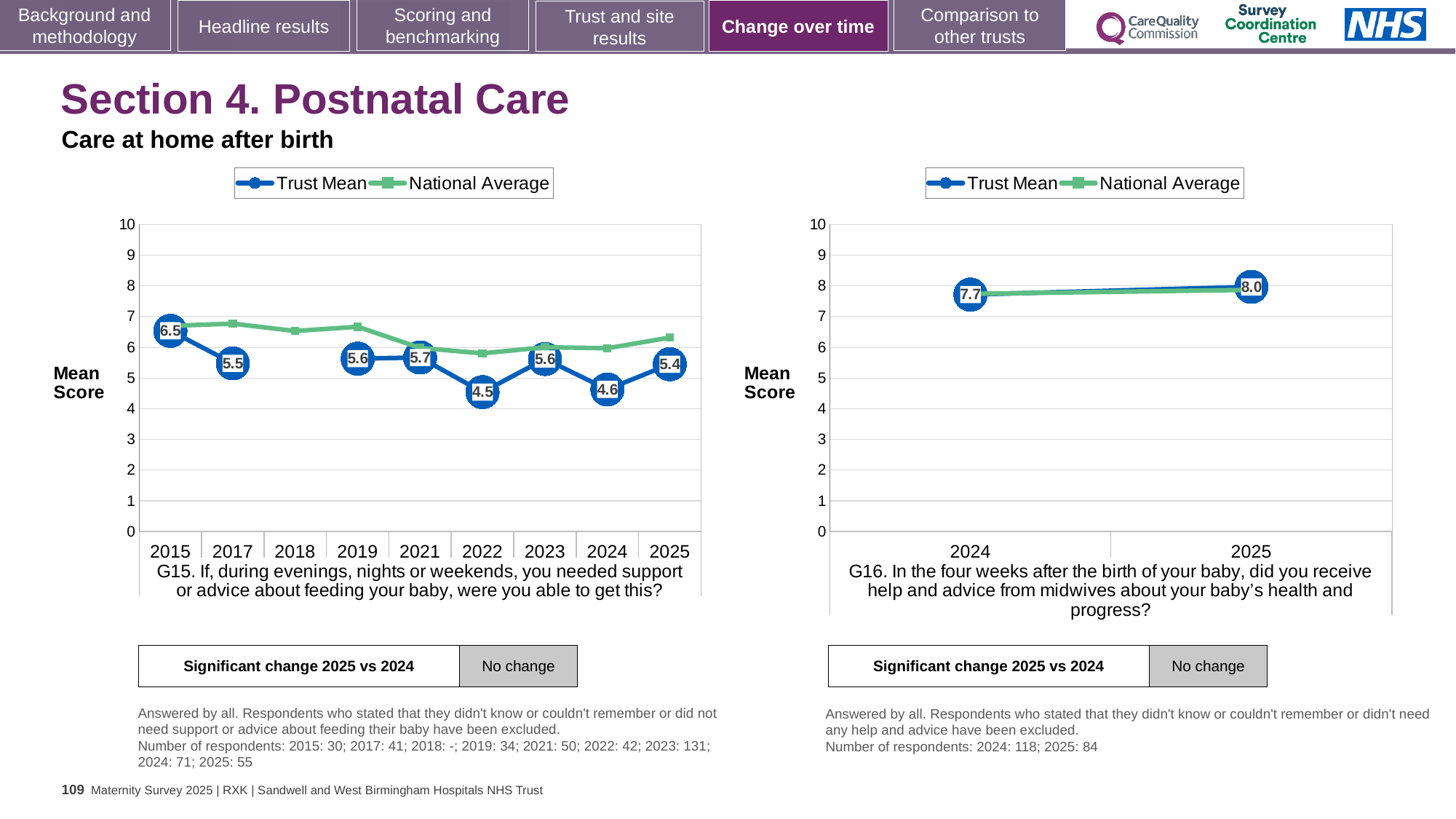
In the G15 chart on the left, what is the Trust Mean score for 2022? 4.5 In the G15 chart on the left, what is the Trust Mean score for 2015? 6.5 In the G15 chart on the left, what is the difference between the Trust Mean scores for 2015 and 2025? 1.1 How many series does the legend of the G16 chart on the right list? 2 In the G16 chart on the right, does the Trust Mean rise or fall from 2024 to 2025? Rise In the G15 chart on the left, is the National Average value for 2015 greater or less than 6? greater In the G16 chart on the right, what is the Trust Mean score for 2025? 8.0 In the G15 chart on the left, which is larger for 2024: the Trust Mean or the National Average? National Average In the G15 chart on the left, which year has the lowest Trust Mean score? 2022 What kind of chart is the G16 chart on the right? Line chart In the G15 chart on the left, how many years are shown on the x axis? 9 In the G15 chart on the left, which year has the highest Trust Mean score? 2015